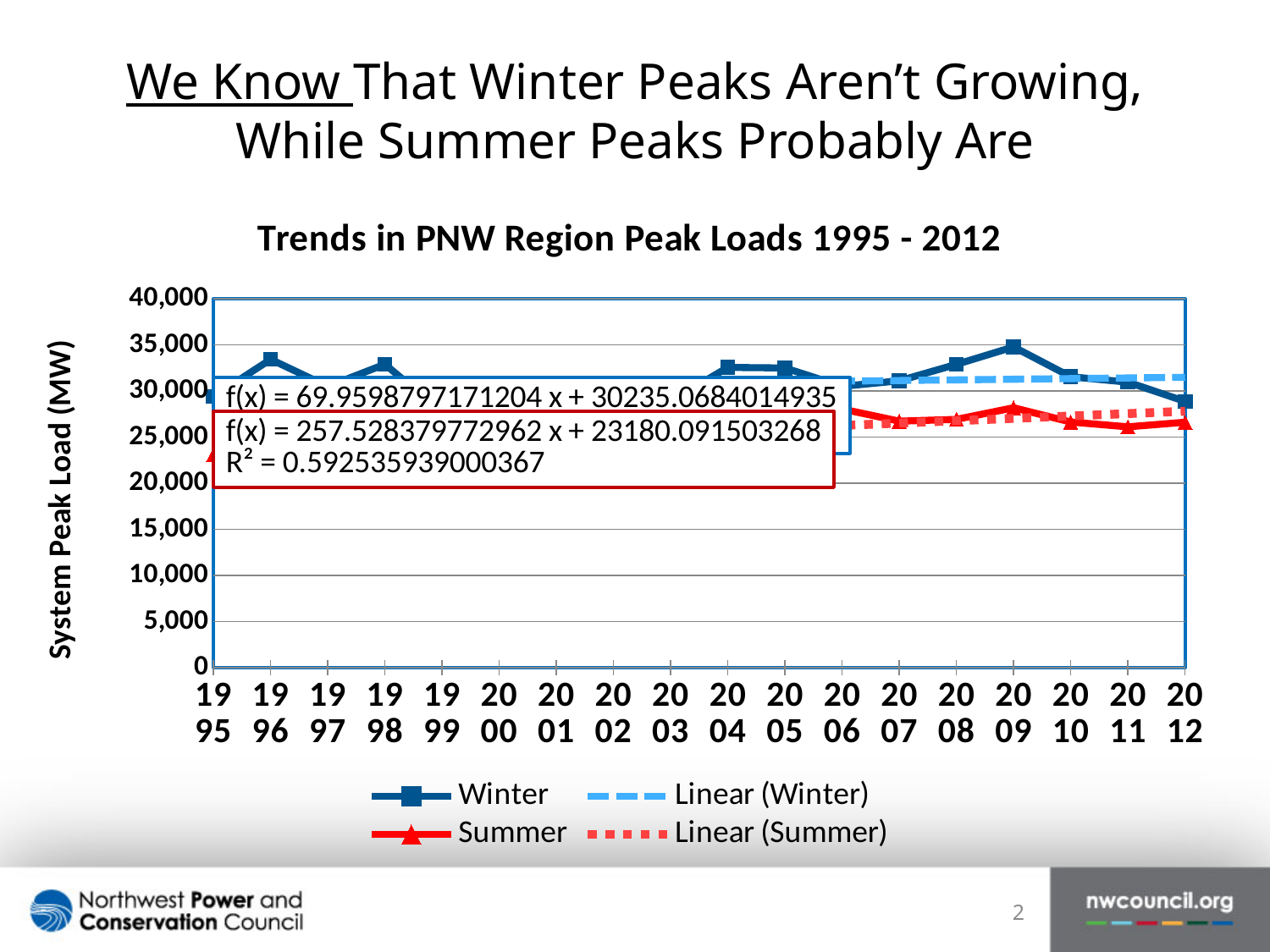
Is the Summer value for 2009 greater or less than 25,000? greater In which year does the Winter series reach its highest value? 2009 How many years are plotted along the x axis? 18 Is the Summer value for 2011 greater or less than 30,000? less What kind of chart is shown on the slide? line chart Is the Winter value for 2009 greater or less than 30,000? greater What is the label of the vertical axis? System Peak Load (MW) Does the Linear (Summer) trendline rise or fall from 1995 to 2012? rise How many entries does the chart legend list? 4 In 2009, which series has the larger value, Winter or Summer? Winter What is the title of the chart? Trends in PNW Region Peak Loads 1995 - 2012